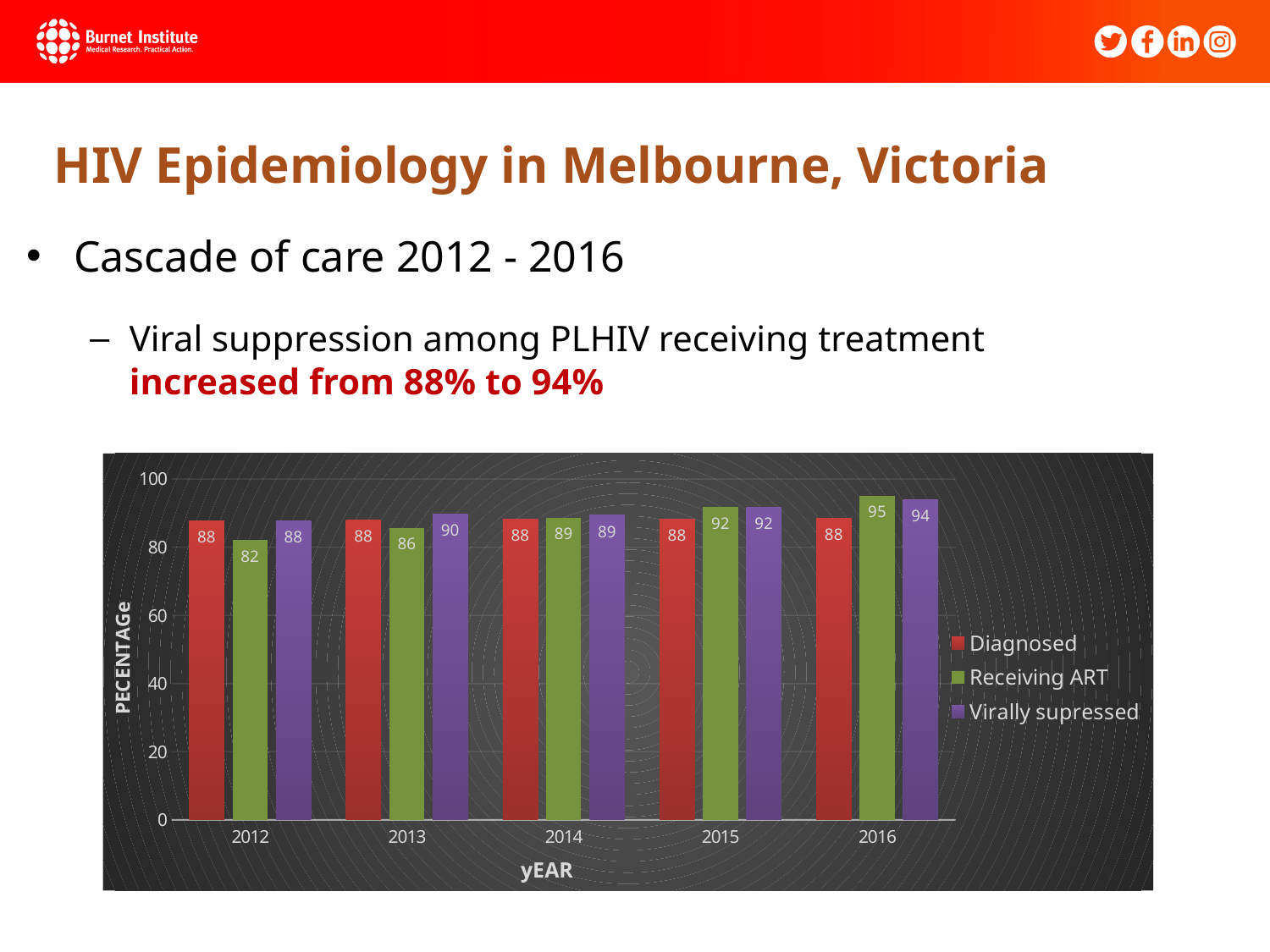
How many series does the legend list? 3 In which year is the Receiving ART value lowest? 2012 Which is larger in 2013: Receiving ART or Virally supressed? Virally supressed In which year is the Receiving ART value highest? 2016 What is the value for Receiving ART in 2012? 82 How many years are shown on the x axis? 5 Does the Receiving ART value rise or fall from 2012 to 2016? Rise What is the value for Virally supressed in 2016? 94 What is the label of the y axis? PECENTAGe What kind of chart is shown on the slide? Bar chart What is the difference between the Virally supressed values in 2016 and 2012? 6 What is the value for Diagnosed in 2014? 88